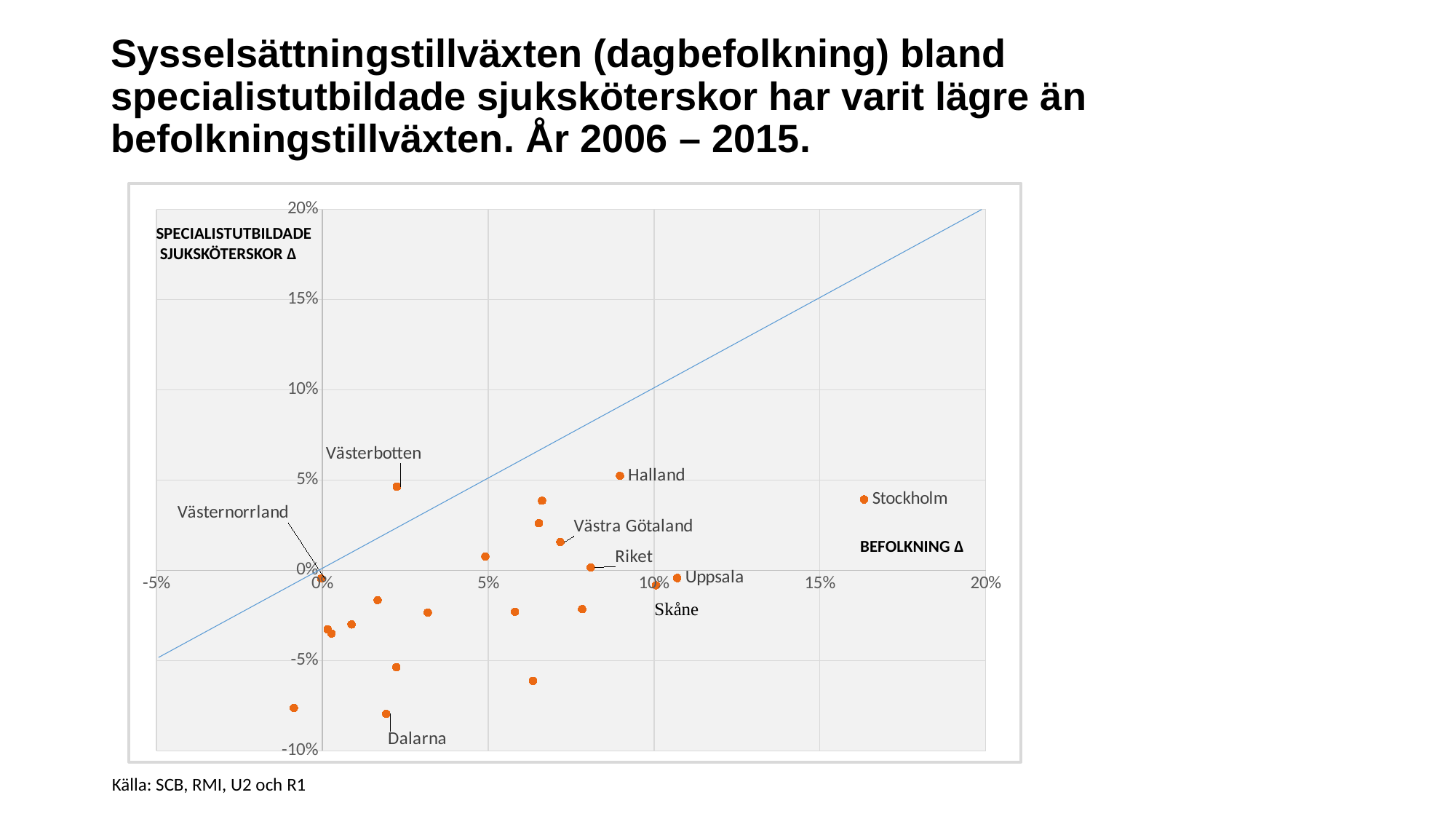
What kind of chart is shown on the slide? Scatter chart What is the label of the vertical axis of the chart? SPECIALISTUTBILDADE SJUKSKÖTERSKOR Δ Which has the higher population growth (x axis), Stockholm or Halland? Stockholm Which labelled region has the highest population growth (BEFOLKNING Δ) on the x axis? Stockholm What source is cited below the chart? Källa: SCB, RMI, U2 och R1 Is the population growth (x axis) for Uppsala greater or less than 10%? greater Is the population growth (x axis) for Halland greater or less than 10%? less Is the population growth (x axis) for Stockholm greater or less than 15%? greater Which has the higher growth in specialist nurses (y axis), Västerbotten or Dalarna? Västerbotten